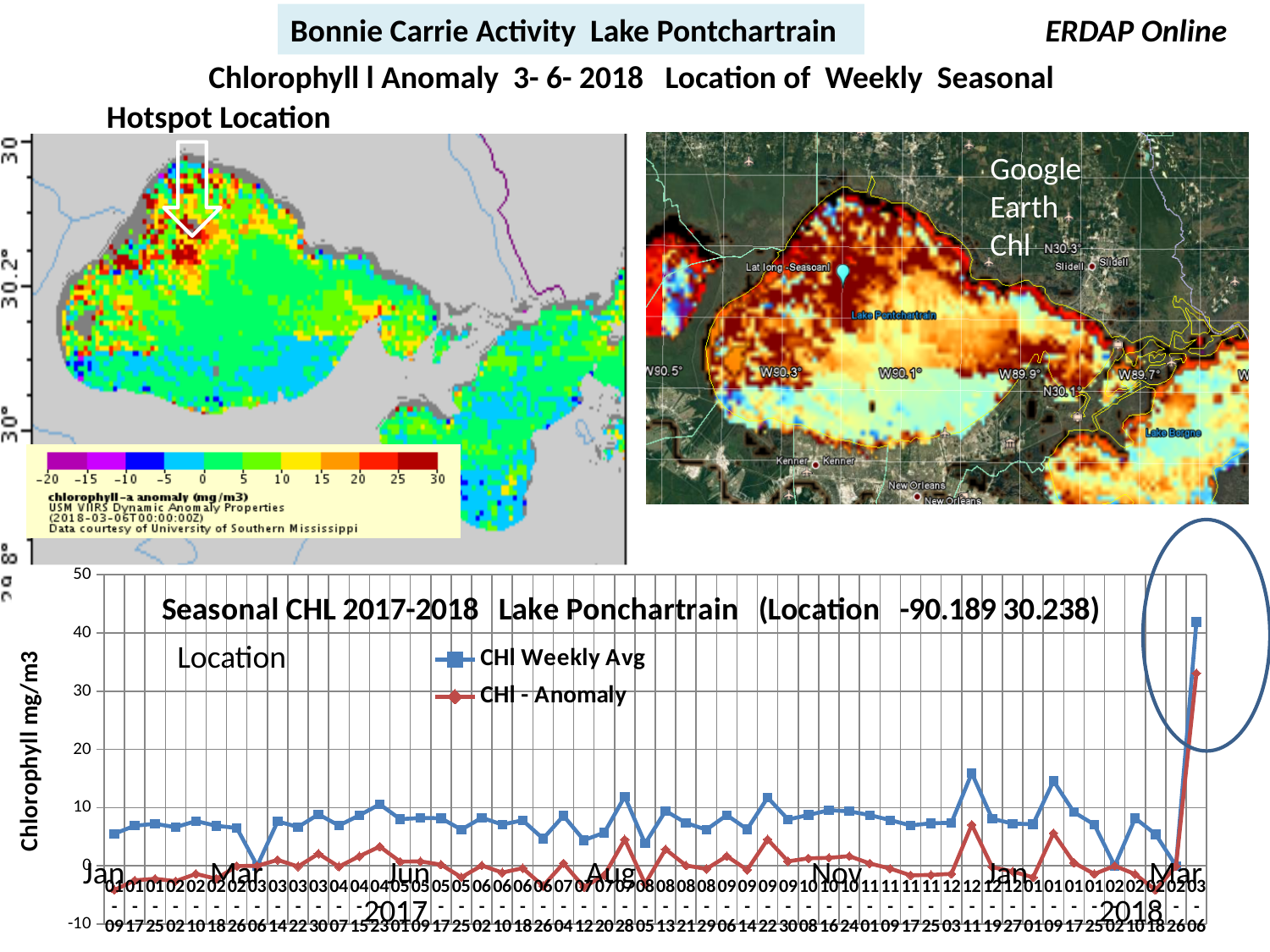
In the 'Seasonal CHL 2017-2018' chart, in which month and year does the sharp spike in both series occur? Mar 2018 In the 'Seasonal CHL 2017-2018' chart, excluding the final spike, are the Chl Weekly Avg values greater or less than 20? less What is the y-axis label of the 'Seasonal CHL 2017-2018' chart? Chlorophyll mg/m3 What kind of chart is the 'Seasonal CHL 2017-2018 Lake Ponchartrain' chart at the bottom of the slide? Line chart In the 'Seasonal CHL 2017-2018' chart, is the peak value of Chl Weekly Avg at the end of the series greater or less than 30? greater How many series does the legend of the 'Seasonal CHL 2017-2018' chart list? 2 In the 'Seasonal CHL 2017-2018' chart, is the peak value of Chl - Anomaly at the end of the series greater or less than 20? greater In the 'Seasonal CHL 2017-2018' chart, which series reaches the highest value on the chart? Chl Weekly Avg In the 'Seasonal CHL 2017-2018' chart, at the final data point, which series has the larger value, Chl Weekly Avg or Chl - Anomaly? Chl Weekly Avg In the 'Seasonal CHL 2017-2018' chart, do the Chl Weekly Avg values rise or fall sharply at the right end of the x axis? rise What are the two series named in the legend of the 'Seasonal CHL 2017-2018' chart? CHl Weekly Avg and CHl - Anomaly